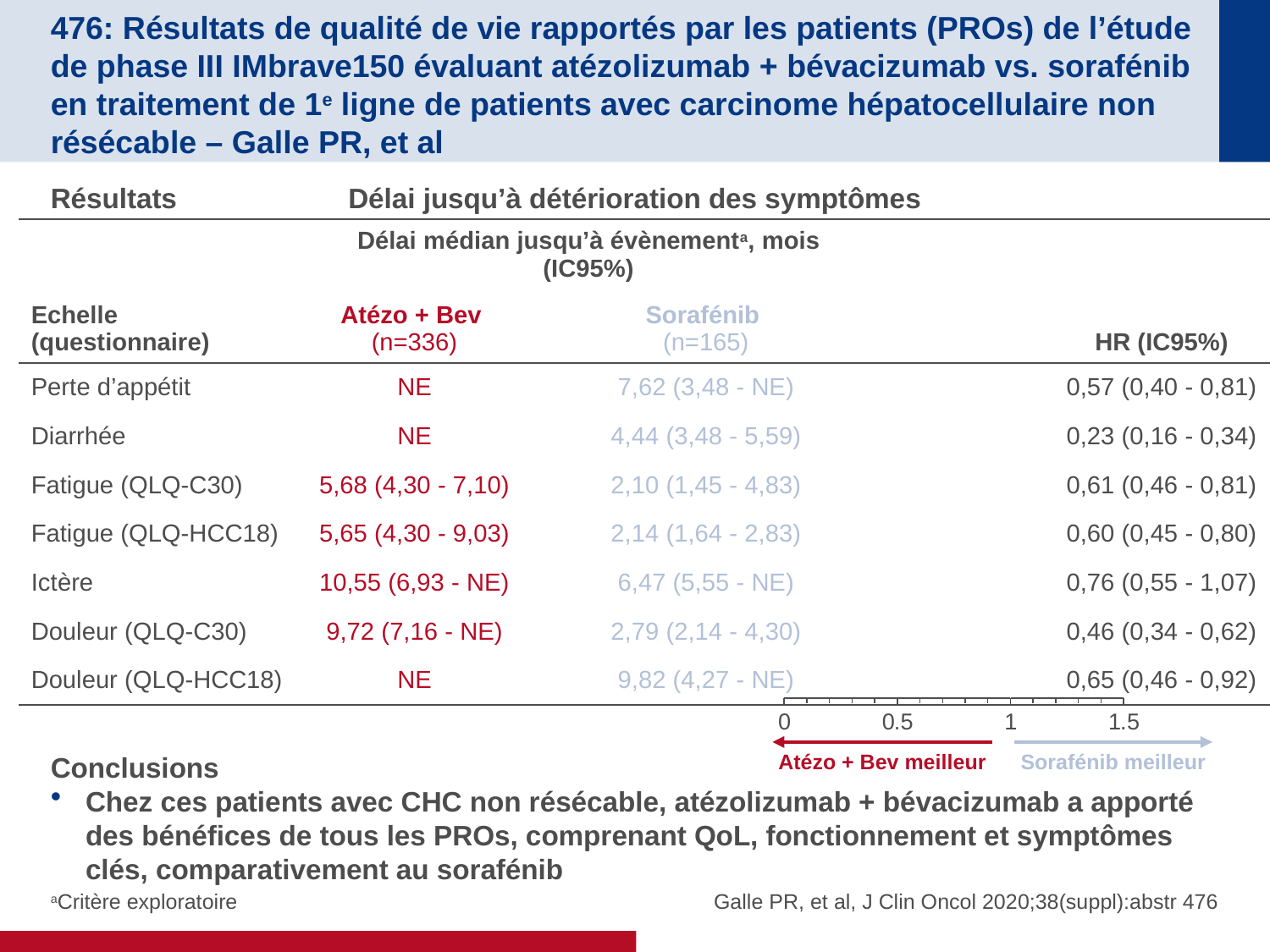
Which has the larger hazard ratio, Perte d'appétit or Fatigue (QLQ-C30)? Fatigue (QLQ-C30) What is the difference between the hazard ratio for Ictère and the hazard ratio for Diarrhée? 0,53 Is the hazard ratio for Ictère greater or less than 1 on the axis? less Which scale has the lowest hazard ratio (HR)? Diarrhée What is the hazard ratio (HR) for Diarrhée? 0,23 (0,16 - 0,34) Which scale has the highest hazard ratio (HR)? Ictère What is the hazard ratio (HR) for Ictère? 0,76 (0,55 - 1,07) What is the highest tick value shown on the hazard ratio axis? 1.5 What is the hazard ratio (HR) for Douleur (QLQ-C30)? 0,46 (0,34 - 0,62) How many scales (questionnaires) are listed in the table? 7 Which treatment is labelled as better on the left side of the hazard ratio axis? Atézo + Bev meilleur